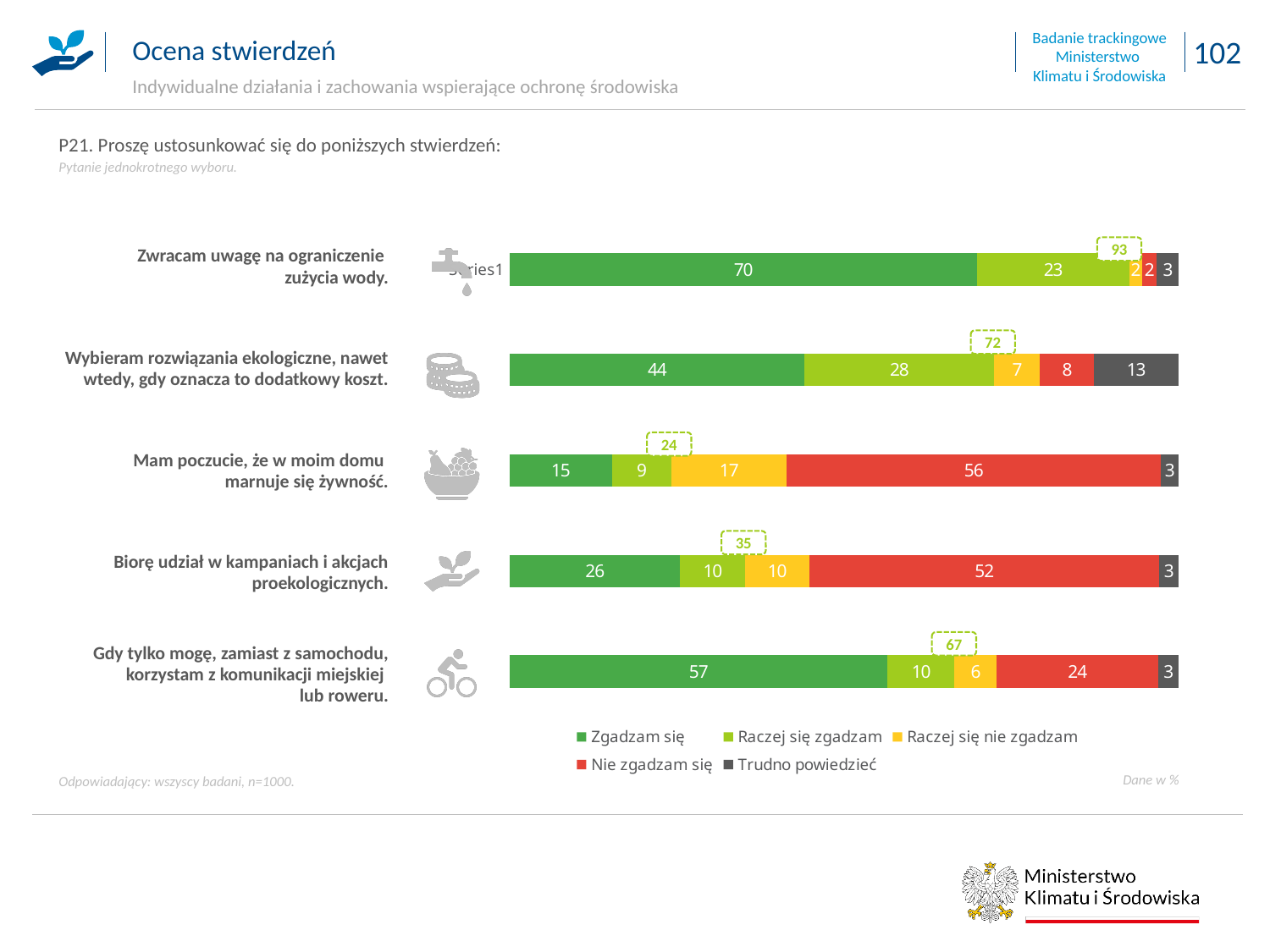
Which is larger: the 'Nie zgadzam się' value for 'Mam poczucie, że w moim domu marnuje się żywność.' or for 'Biorę udział w kampaniach i akcjach proekologicznych.'? Mam poczucie, że w moim domu marnuje się żywność. What type of chart is shown on the slide? stacked bar chart How many statements (categories) are plotted in the chart? 5 What is the value of 'Nie zgadzam się' for the statement 'Mam poczucie, że w moim domu marnuje się żywność.'? 56 What is the difference between the 'Zgadzam się' values for 'Gdy tylko mogę, zamiast z samochodu, korzystam z komunikacji miejskiej lub roweru.' and 'Biorę udział w kampaniach i akcjach proekologicznych.'? 31 How many series does the legend list? 5 Which statement has the highest 'Zgadzam się' value? Zwracam uwagę na ograniczenie zużycia wody. Which statement has the lowest 'Zgadzam się' value? Mam poczucie, że w moim domu marnuje się żywność. What is the value of 'Trudno powiedzieć' for the statement 'Wybieram rozwiązania ekologiczne, nawet wtedy, gdy oznacza to dodatkowy koszt.'? 13 Which legend entry is shown in red? Nie zgadzam się What is the value of 'Zgadzam się' for the statement 'Zwracam uwagę na ograniczenie zużycia wody.'? 70 What is the combined value of 'Zgadzam się' and 'Raczej się zgadzam' shown above the bar for 'Wybieram rozwiązania ekologiczne, nawet wtedy, gdy oznacza to dodatkowy koszt.'? 72